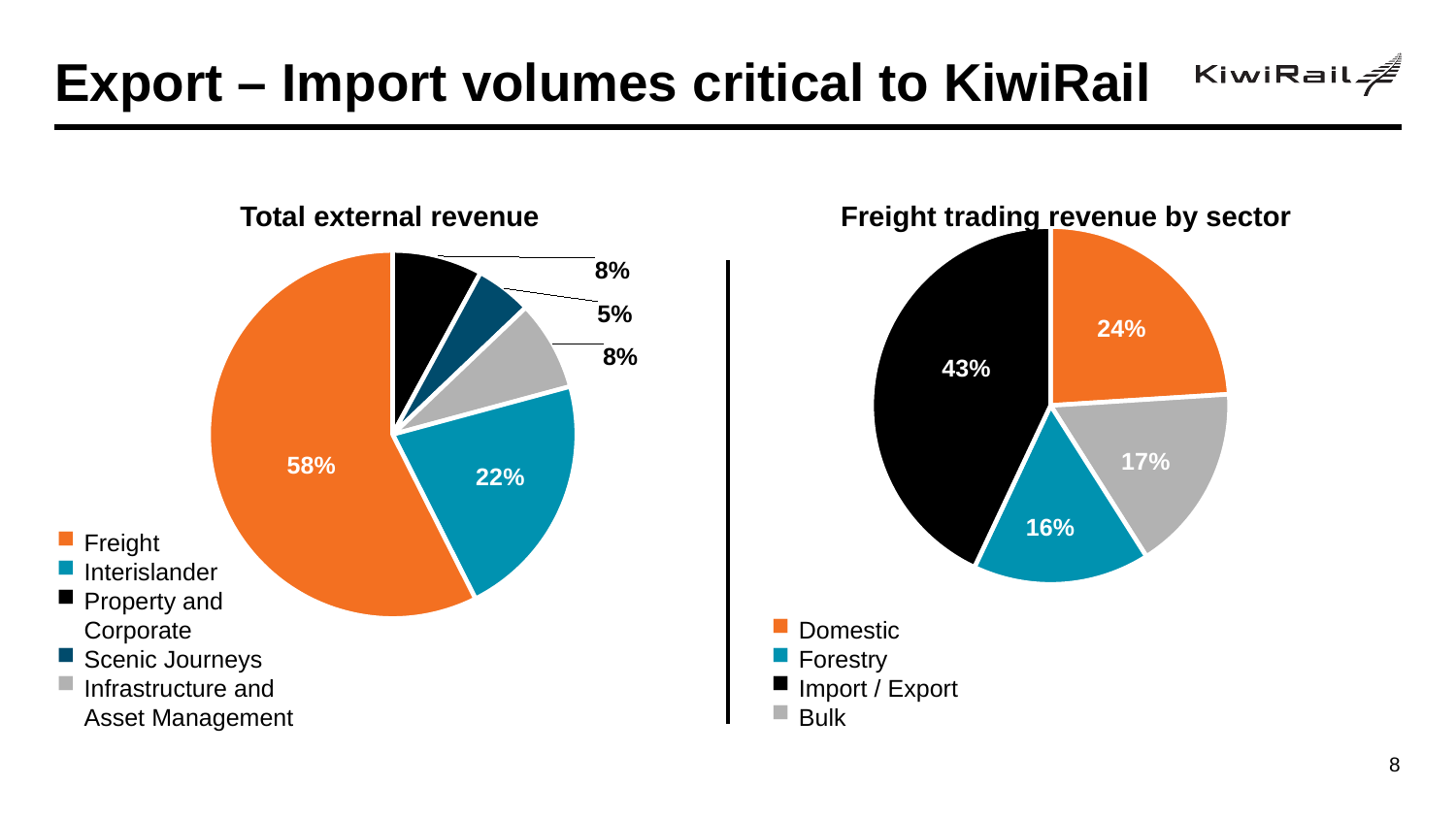
In the 'Total external revenue' pie chart, what share does Freight have? 58% In the 'Total external revenue' pie chart, which category has the largest share? Freight In the 'Total external revenue' pie chart, which category has the smallest share? Scenic Journeys In the 'Freight trading revenue by sector' pie chart, what is the difference between the Import / Export share and the Domestic share? 19% In the 'Freight trading revenue by sector' pie chart, which sector has the smallest share? Forestry In the 'Freight trading revenue by sector' pie chart, what share does Domestic have? 24% What kind of chart is used for 'Freight trading revenue by sector'? Pie chart In the 'Total external revenue' pie chart, how many categories does the legend list? 5 In the 'Total external revenue' pie chart, what share does Interislander have? 22% In the 'Freight trading revenue by sector' pie chart, which is larger, Bulk or Forestry? Bulk